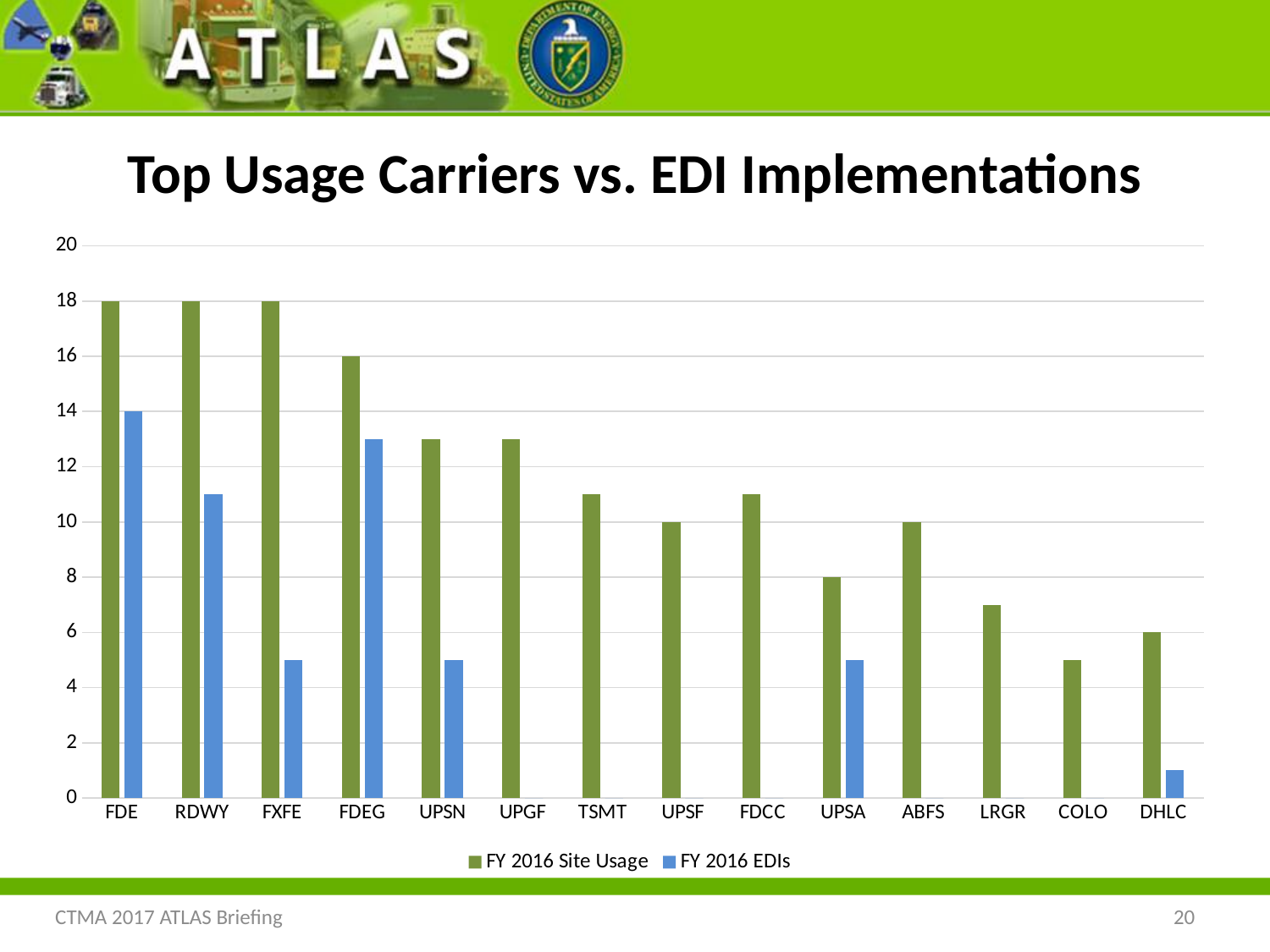
What is the FY 2016 Site Usage value for FDEG? 16 How many carriers are shown along the x axis? 14 What is the difference between FY 2016 Site Usage and FY 2016 EDIs for FDE? 4 What is the FY 2016 Site Usage value for FDE? 18 Which has the higher FY 2016 Site Usage, FDEG or UPSA? FDEG How many series does the legend list? 2 What kind of chart is shown on the slide? bar chart Which carrier has the highest FY 2016 EDIs value? FDE Do the FY 2016 Site Usage values generally rise or fall from left to right along the x axis? fall What is the FY 2016 EDIs value for FDE? 14 Is the FY 2016 Site Usage value for UPSN greater or less than 12? greater What is the FY 2016 Site Usage value for UPSA? 8